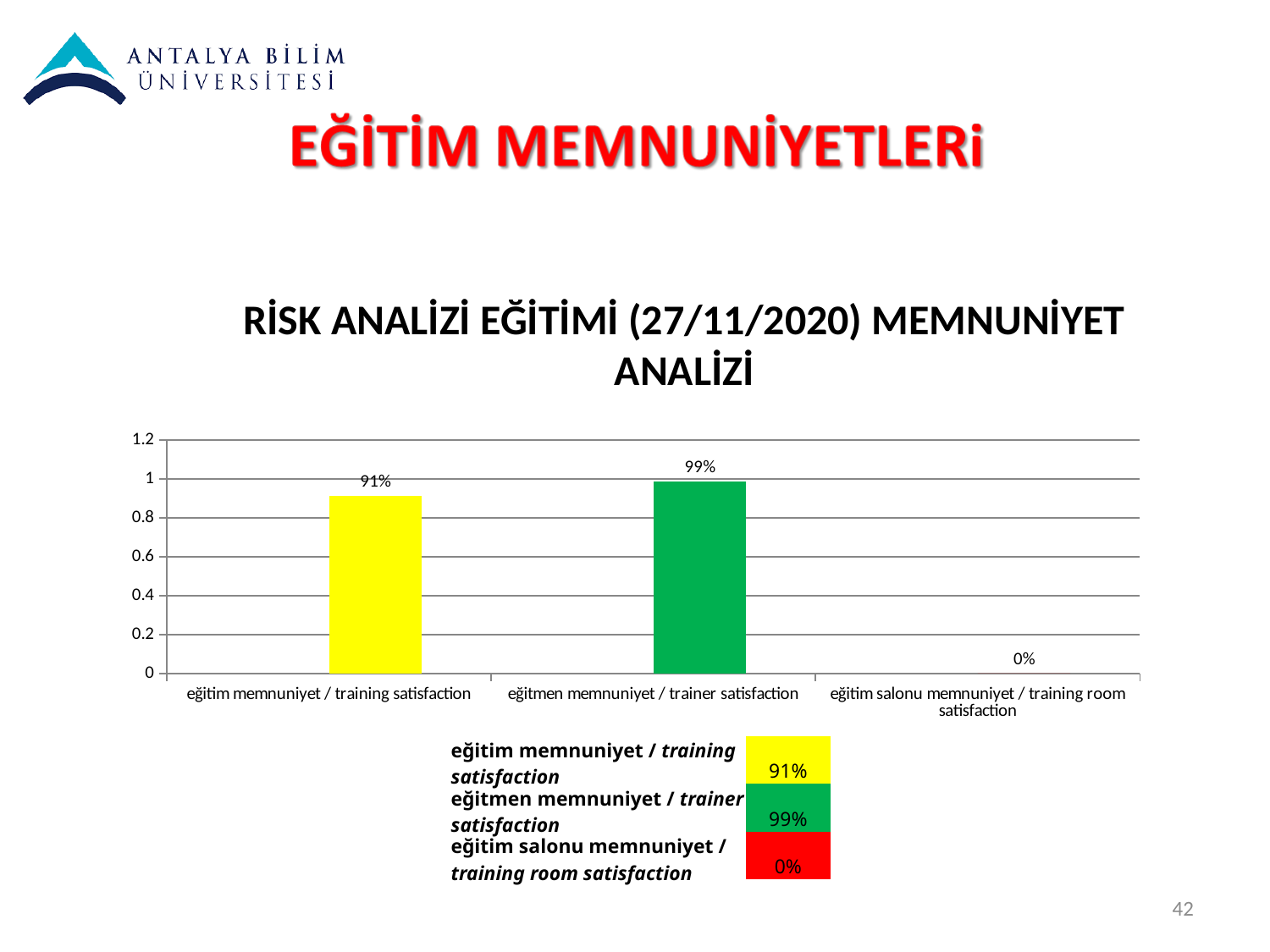
Which is larger, the value for training satisfaction or the value for trainer satisfaction? trainer satisfaction Which category has the highest value? eğitmen memnuniyet / trainer satisfaction Is the value for eğitim memnuniyet / training satisfaction greater or less than 0.8 on the axis? greater What is the value for eğitmen memnuniyet / trainer satisfaction? 99% What is the difference between the trainer satisfaction value and the training satisfaction value? 8% Which category has the lowest value? eğitim salonu memnuniyet / training room satisfaction What is the value for eğitim memnuniyet / training satisfaction? 91% What is the title of the chart? RİSK ANALİZİ EĞİTİMİ (27/11/2020) MEMNUNİYET ANALİZİ How many categories are shown on the x axis of the chart? 3 What colour is the bar for eğitmen memnuniyet / trainer satisfaction? green What is the value for eğitim salonu memnuniyet / training room satisfaction? 0% What type of chart is shown on the slide? bar chart